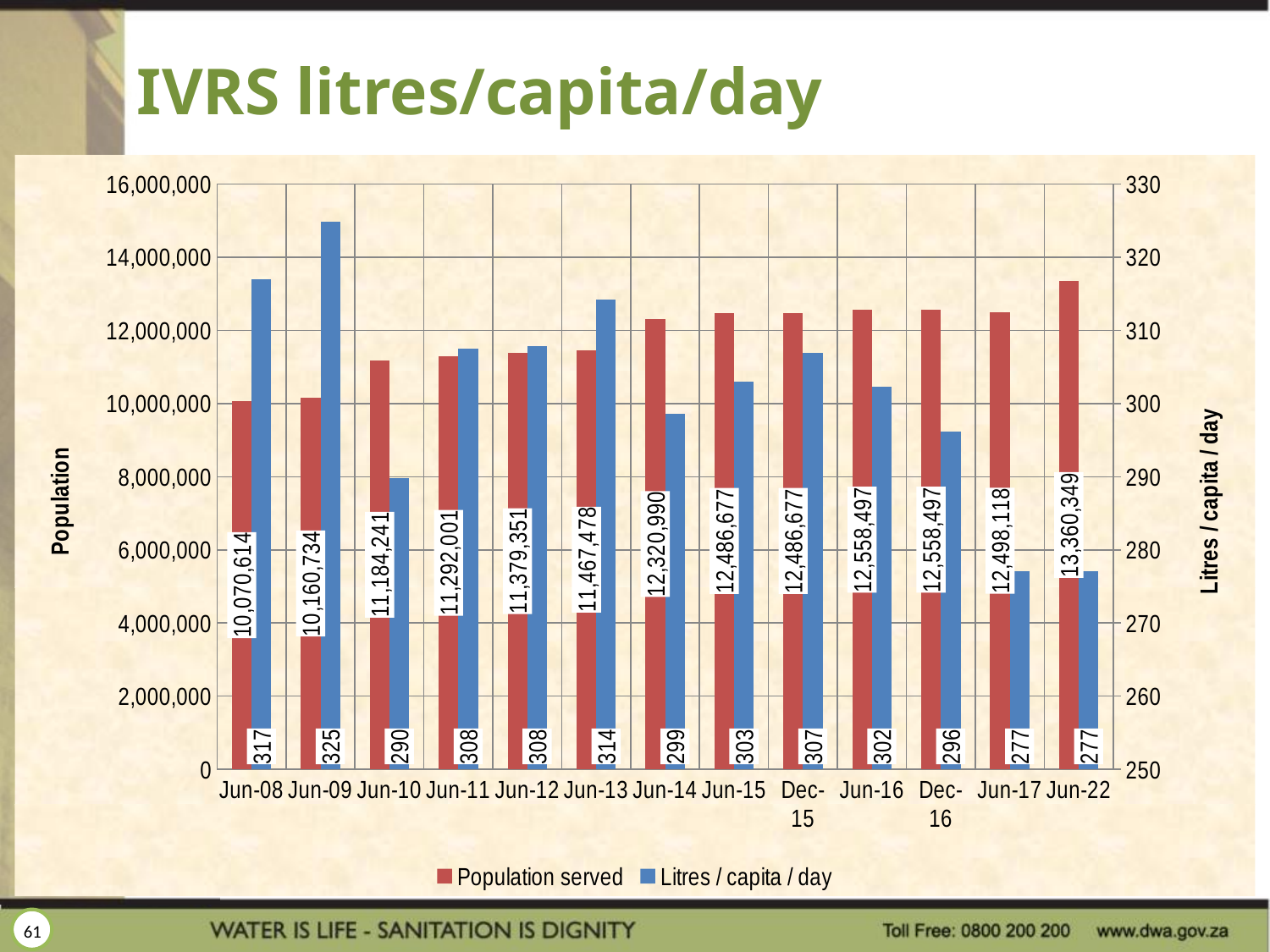
What is the Population served value for Jun-14? 12,320,990 What kind of chart is shown on the slide? Bar chart Which period has a larger Population served value, Jun-12 or Jun-13? Jun-13 How many series does the legend list? 2 What is the Population served value for Jun-22? 13,360,349 What is the Litres / capita / day value for Jun-09? 325 What is the difference between the Litres / capita / day values for Jun-08 and Jun-10? 27 Which period has the lowest Population served value? Jun-08 What is the difference between the Population served values for Jun-22 and Jun-17? 862,231 How many periods are shown on the x axis? 13 Which period has the highest Litres / capita / day value? Jun-09 Which period has the highest Population served value? Jun-22